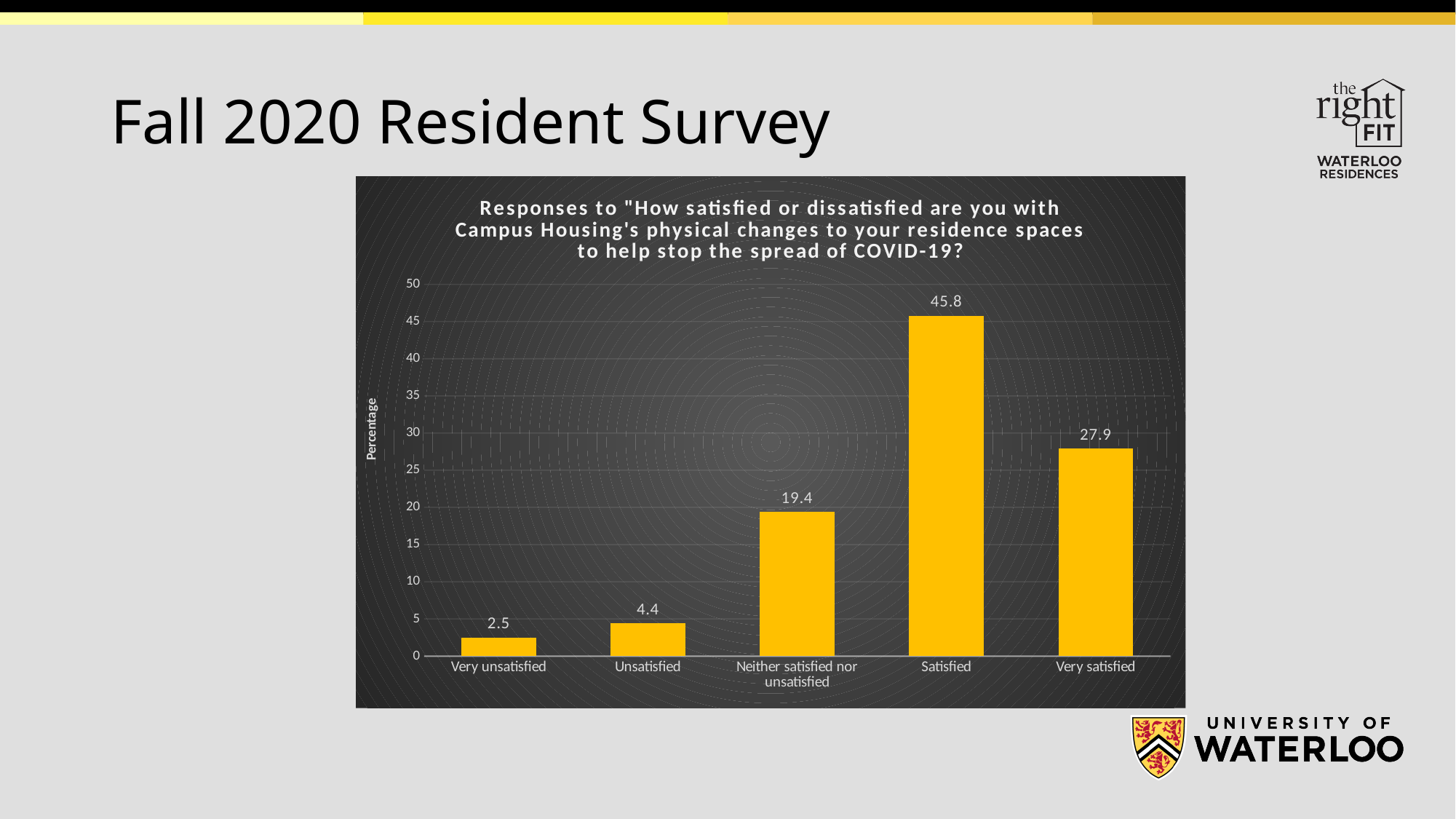
What is the value for Neither satisfied nor unsatisfied? 19.4 What kind of chart is shown on the slide? bar chart How many categories are shown on the x axis? 5 What is the difference between the values for Satisfied and Very satisfied? 17.9 Which category has the highest value? Satisfied Which category has the lowest value? Very unsatisfied Is the value for Very satisfied greater or less than 25? greater What is the value for Very satisfied? 27.9 Which is larger, the value for Unsatisfied or the value for Neither satisfied nor unsatisfied? Neither satisfied nor unsatisfied What is the value for Satisfied? 45.8 What is the label of the vertical axis? Percentage What is the value for Very unsatisfied? 2.5